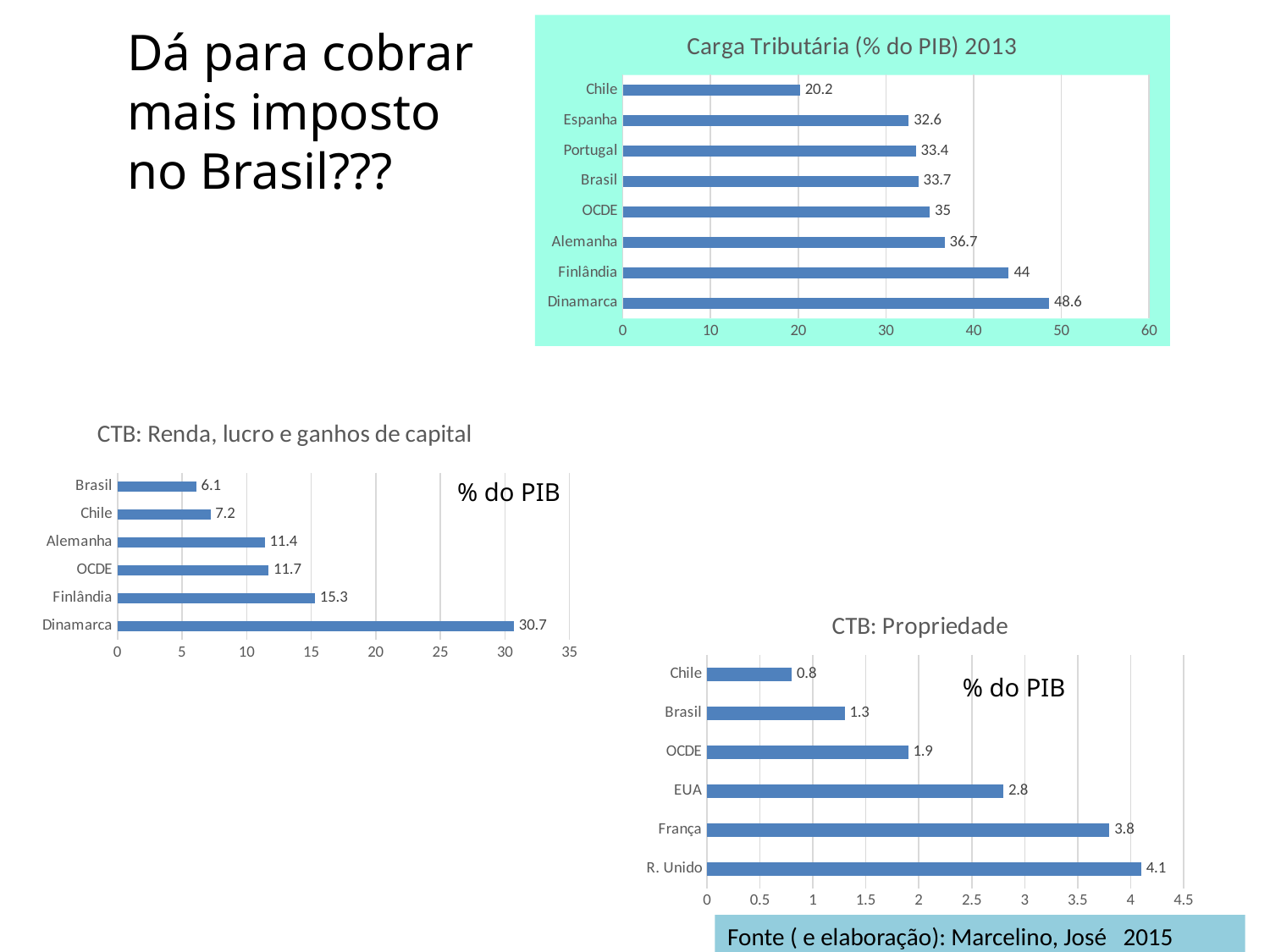
In the 'CTB: Renda, lucro e ganhos de capital' chart, what is the value for Finlândia? 15.3 In the 'CTB: Renda, lucro e ganhos de capital' chart, which category has the highest value? Dinamarca In the 'Carga Tributária (% do PIB) 2013' chart, what is the value for Brasil? 33.7 In the 'Carga Tributária (% do PIB) 2013' chart, what is the difference between Dinamarca and Brasil? 14.9 In the 'CTB: Propriedade' chart, what is the difference between R. Unido and Brasil? 2.8 In the 'Carga Tributária (% do PIB) 2013' chart, how many categories are shown? 8 In the 'Carga Tributária (% do PIB) 2013' chart, which country has the lowest value? Chile In the 'CTB: Renda, lucro e ganhos de capital' chart, which is larger, Alemanha or OCDE? OCDE In the 'Carga Tributária (% do PIB) 2013' chart, which country has the highest value? Dinamarca In the 'CTB: Propriedade' chart, which category has the lowest value? Chile What type of chart is the 'CTB: Propriedade' chart? Bar chart In the 'CTB: Propriedade' chart, what is the value for EUA? 2.8